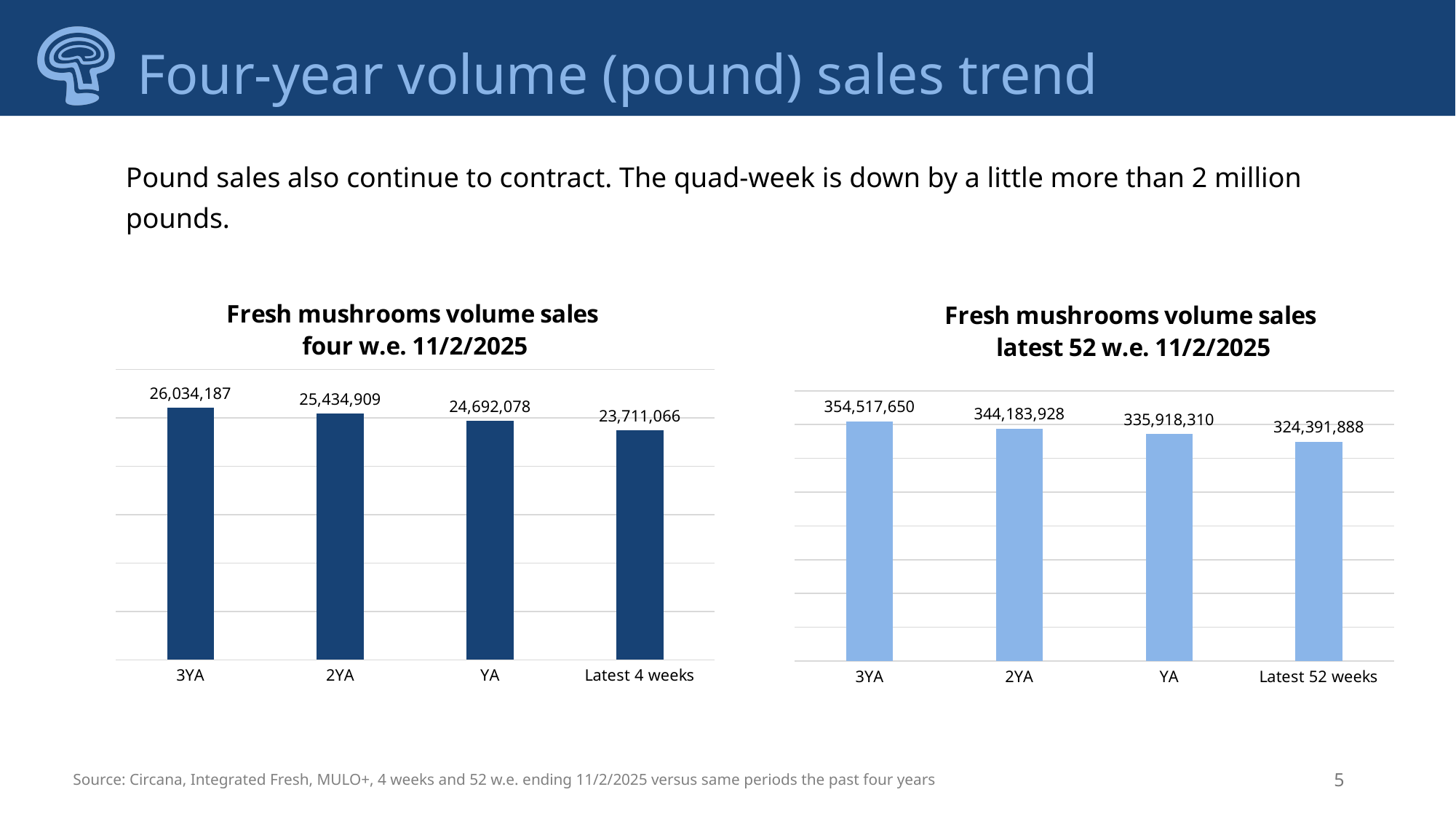
In the 'Fresh mushrooms volume sales four w.e. 11/2/2025' chart, which category has the highest value? 3YA In the 'Fresh mushrooms volume sales four w.e. 11/2/2025' chart, what is the value for Latest 4 weeks? 23,711,066 In the 'Fresh mushrooms volume sales four w.e. 11/2/2025' chart, what is the difference between the 3YA value and the Latest 4 weeks value? 2,323,121 In the 'Fresh mushrooms volume sales latest 52 w.e. 11/2/2025' chart, what is the value for 2YA? 344,183,928 How many categories are shown in the 'Fresh mushrooms volume sales latest 52 w.e. 11/2/2025' chart? 4 In the 'Fresh mushrooms volume sales latest 52 w.e. 11/2/2025' chart, what is the value for Latest 52 weeks? 324,391,888 In the 'Fresh mushrooms volume sales latest 52 w.e. 11/2/2025' chart, what is the difference between the YA value and the Latest 52 weeks value? 11,526,422 In the 'Fresh mushrooms volume sales four w.e. 11/2/2025' chart, what is the value for 3YA? 26,034,187 In the 'Fresh mushrooms volume sales four w.e. 11/2/2025' chart, which is larger, the value for 2YA or the value for YA? 2YA In the 'Fresh mushrooms volume sales latest 52 w.e. 11/2/2025' chart, which category has the lowest value? Latest 52 weeks In the 'Fresh mushrooms volume sales latest 52 w.e. 11/2/2025' chart, do the values rise or fall from 3YA to Latest 52 weeks? Fall What kind of chart is the 'Fresh mushrooms volume sales four w.e. 11/2/2025' chart? Bar chart